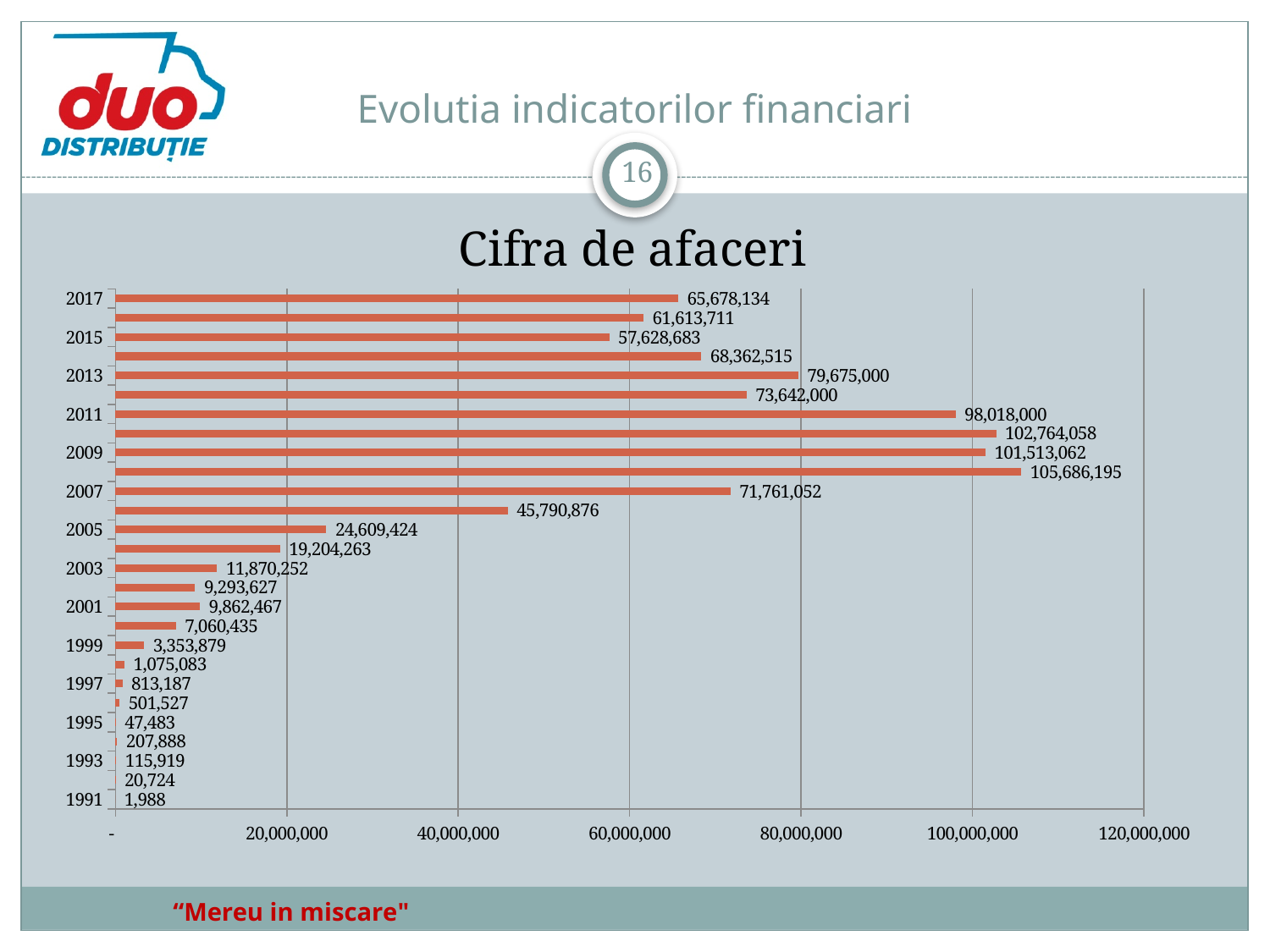
What is the value for 1999 in the Cifra de afaceri chart? 3,353,879 What is the value for 2011 in the Cifra de afaceri chart? 98,018,000 What kind of chart is used to show Cifra de afaceri? Bar chart What is the value for 2005 in the Cifra de afaceri chart? 24,609,424 What is the highest value shown in the Cifra de afaceri chart? 105,686,195 What is the difference between the values for 2017 and 2015 in the Cifra de afaceri chart? 8,049,451 How many bars are plotted in the Cifra de afaceri chart? 27 Which year has the larger value in the Cifra de afaceri chart, 2009 or 2011? 2009 What is the difference between the values for 2011 and 2013 in the Cifra de afaceri chart? 18,343,000 Which year has the lowest value in the Cifra de afaceri chart? 1991 What is the value for 2017 in the Cifra de afaceri chart? 65,678,134 Is the value for 2015 in the Cifra de afaceri chart greater or less than 60,000,000? less